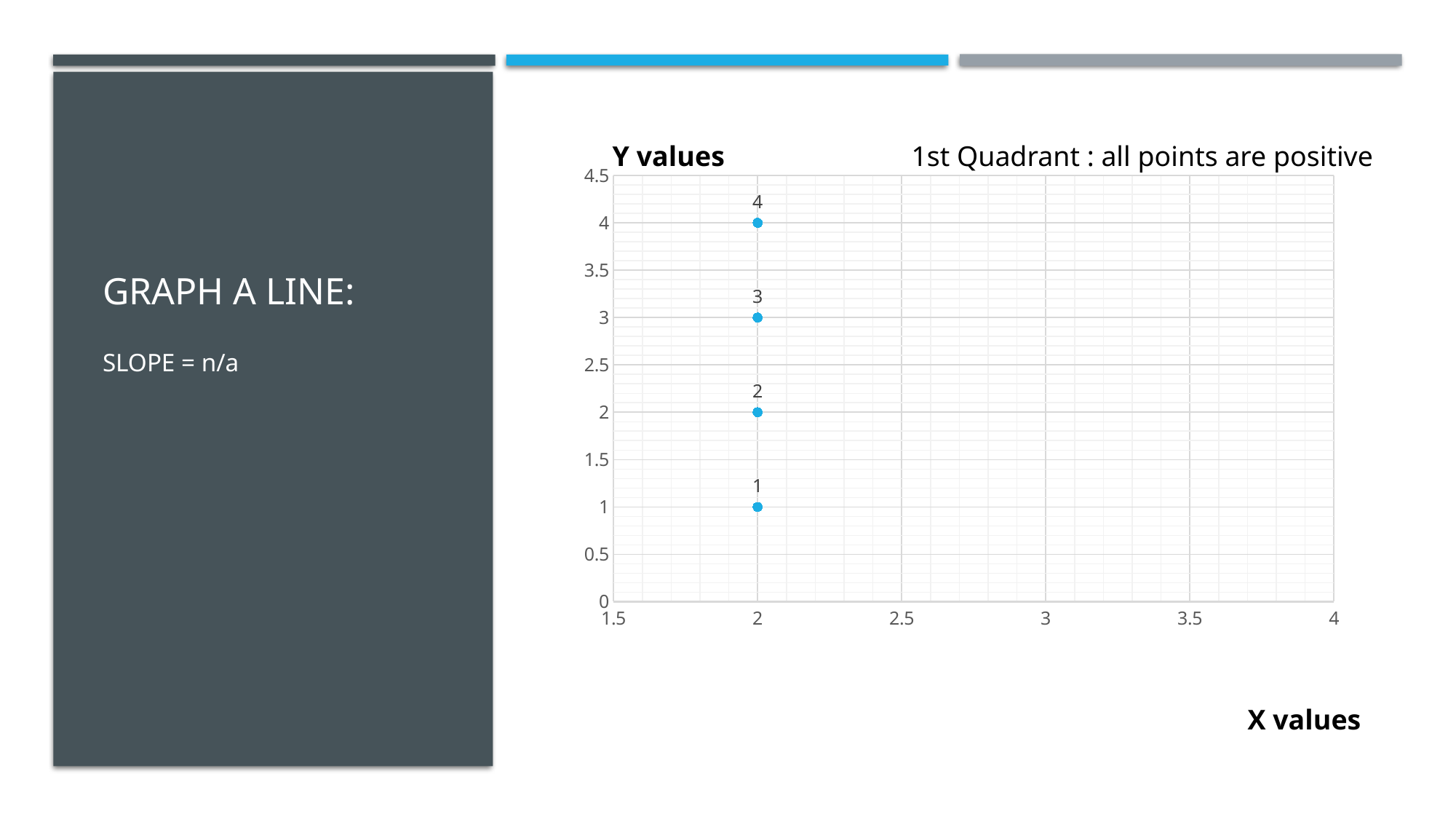
How many data points are plotted on the chart? 4 What is the maximum value shown on the y axis? 4.5 Is the y value of the topmost point greater or less than 3.5? greater What is the highest y value labelled on the chart? 4 What is the title of the chart? 1st Quadrant : all points are positive What is the difference between the highest and lowest labelled y values? 3 What kind of chart is shown on the slide? scatter chart What is the label on the vertical axis of the chart? Y values What x value do all the plotted points share? 2 Is the y value of the lowest point greater or less than 1.5? less What is the lowest y value labelled on the chart? 1 What is the minimum value shown on the x axis? 1.5